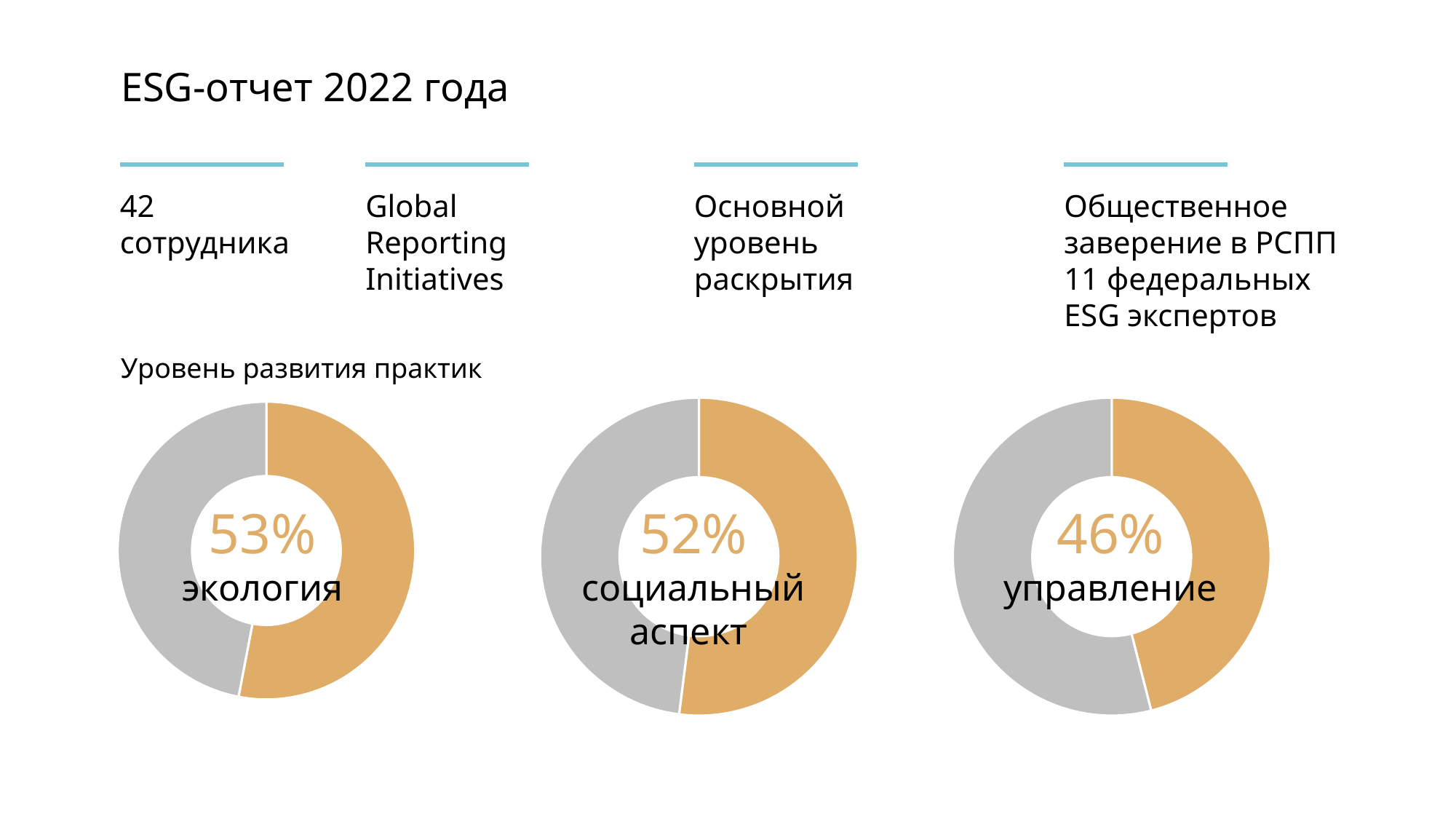
What kind of chart is used to show the 'Уровень развития практик' values? Donut (pie) chart What percentage is shown in the centre of the 'социальный аспект' donut chart? 52% What percentage is shown in the centre of the 'экология' donut chart? 53% In the 'экология' donut chart, what share of the ring is filled with the orange colour? 53% What is the difference in percentage points between the 'экология' chart value and the 'управление' chart value? 7 percentage points How many donut charts are shown under 'Уровень развития практик'? 3 What percentage is shown in the centre of the 'управление' donut chart? 46% Which of the three donut charts under 'Уровень развития практик' shows the highest percentage? экология Which of the three donut charts under 'Уровень развития практик' shows the lowest percentage? управление What is the heading printed above the three donut charts? Уровень развития практик Which is larger: the percentage in the 'социальный аспект' chart or the percentage in the 'управление' chart? социальный аспект Is the value shown in the 'управление' donut chart greater or less than 50%? less